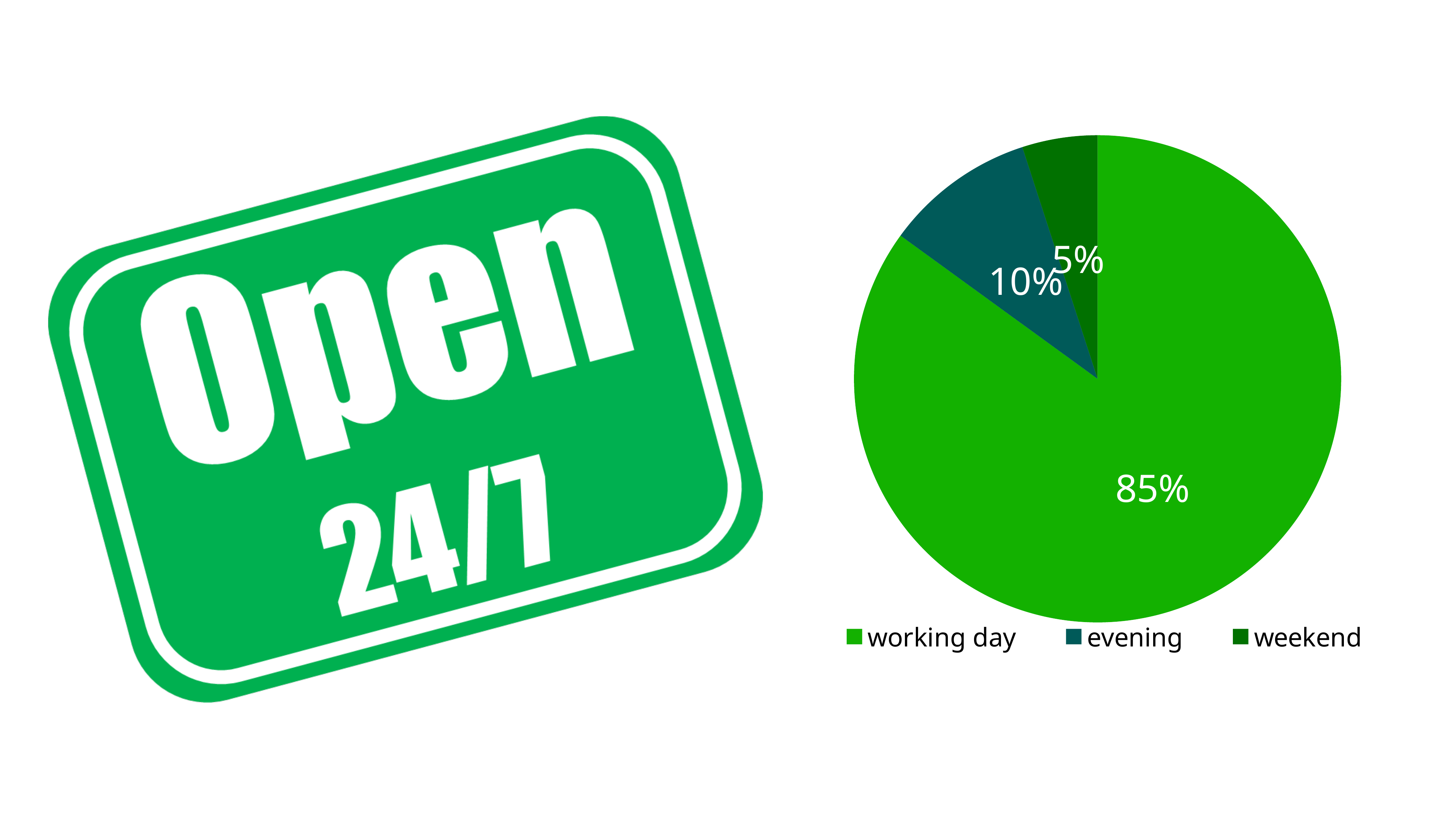
What is the difference between the working day and evening values? 75% What is the value for weekend? 5% What is the value for evening? 10% Which legend entry is shown in the lightest green colour? working day How many entries does the legend list? 3 How many slices does the pie chart have? 3 Which is larger, the evening value or the weekend value? evening Which category has the largest share of the pie? working day Which category has the smallest share of the pie? weekend What kind of chart is shown on the slide? pie chart What is the value for working day? 85% What is the difference between the evening and weekend values? 5%